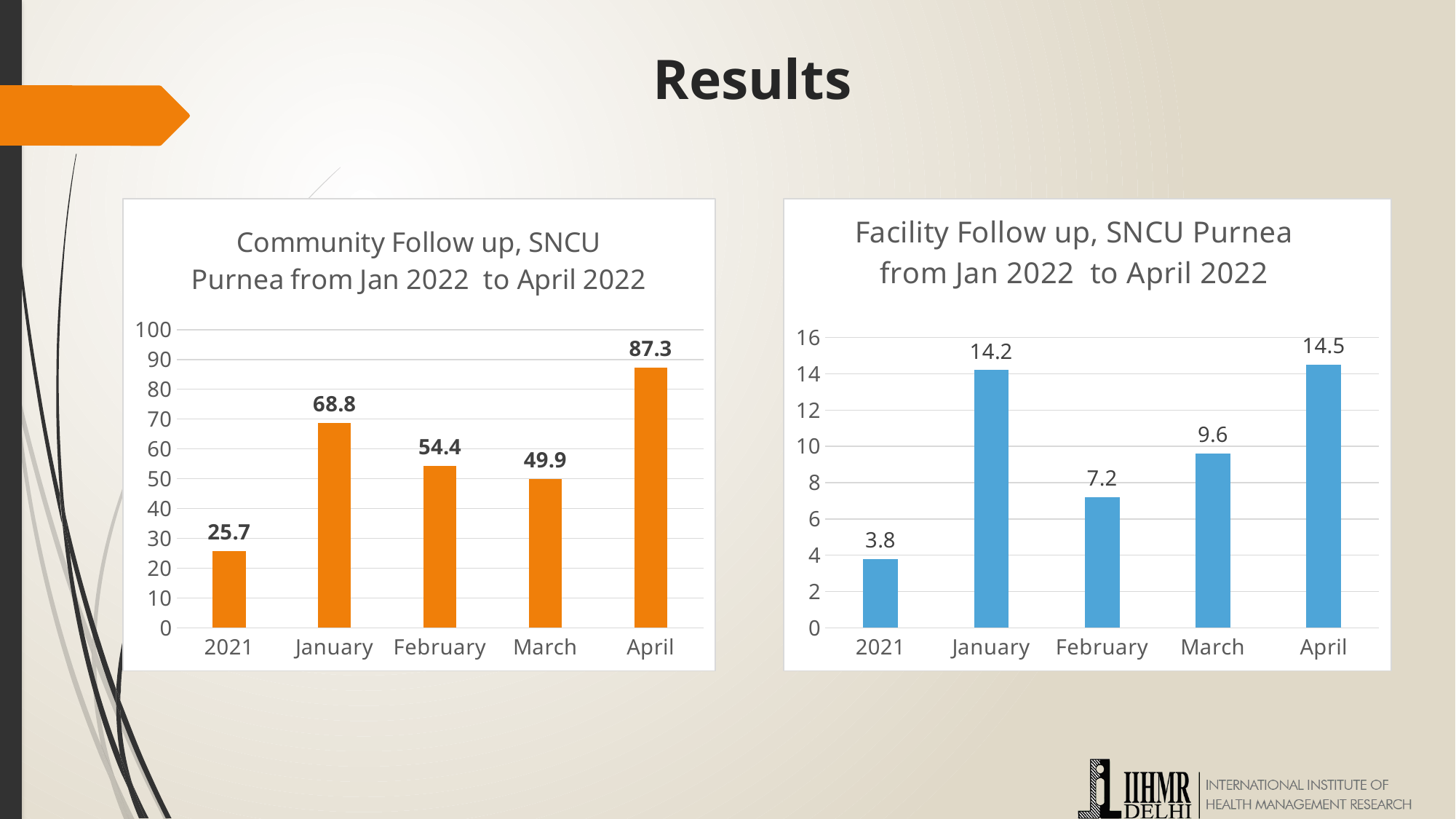
In the Community Follow up chart, do the values rise or fall from January to March? fall In the Community Follow up chart, which category has the highest value? April What kind of chart is the Facility Follow up chart? bar chart In the Community Follow up chart, what is the difference between the values for April and 2021? 61.6 In the Facility Follow up chart, which category has the lowest value? 2021 What colour are the bars in the Facility Follow up chart? blue In the Facility Follow up chart, what is the value for March? 9.6 In the Facility Follow up chart, is the value for 2021 greater or less than 4? less In the Community Follow up chart, what is the value for January? 68.8 In the Facility Follow up chart, what is the difference between the values for January and February? 7.0 How many categories are shown on the x axis of the Community Follow up chart? 5 In the Community Follow up chart, which is larger, the value for February or the value for March? February